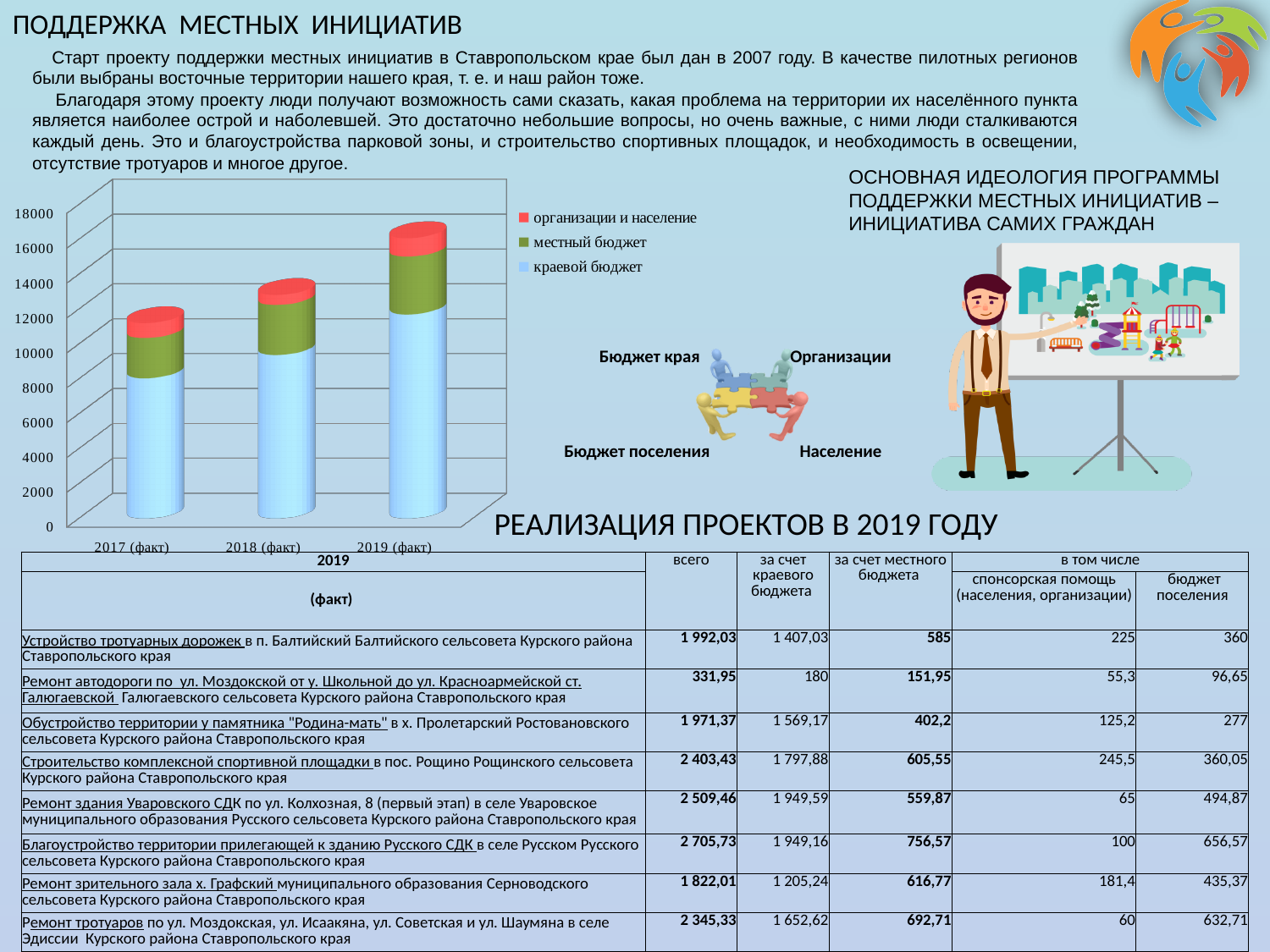
Which series is shown in red in the bar chart? организации и население Which stacked bar is taller, 2017 (факт) or 2019 (факт)? 2019 (факт) How many categories are shown on the x axis of the bar chart? 3 Which year has the tallest stacked bar in the chart? 2019 (факт) Is the краевой бюджет value for 2017 (факт) greater or less than 10000? less Which series is shown in light blue in the bar chart? краевой бюджет Is the total of the stacked bar for 2017 (факт) greater or less than 14000? less How many series does the legend of the bar chart list? 3 Is the total of the stacked bar for 2019 (факт) greater or less than 14000? greater Do the stacked bar totals rise or fall from 2017 (факт) to 2019 (факт)? rise Which year has the shortest stacked bar in the chart? 2017 (факт) What kind of chart is shown on the slide? bar chart